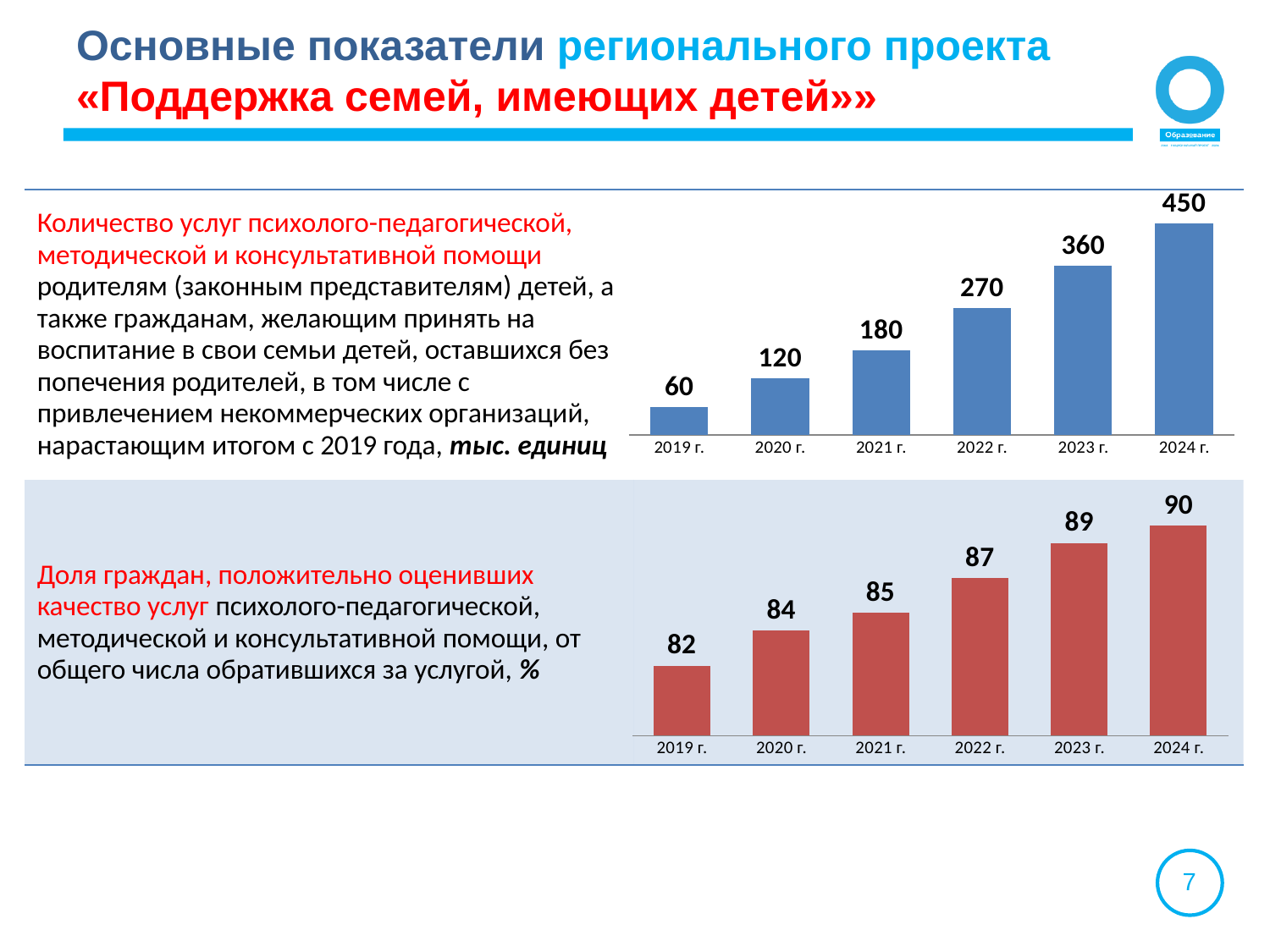
In the top chart (number of services, thousand units), how many years are shown on the x axis? 6 In the top chart (number of services, thousand units), what is the difference between the values for 2024 г. and 2019 г.? 390 In the top chart (number of services, thousand units), do the values rise or fall from 2019 г. to 2024 г.? rise In the bottom chart (share of citizens positively rating service quality, %), what is the value for 2021 г.? 85 In the bottom chart (share of citizens positively rating service quality, %), which year has the lowest value? 2019 г. What type of chart is the bottom chart (share of citizens positively rating service quality, %)? bar chart In the top chart (number of services, thousand units), which year has the highest value? 2024 г. In the top chart (number of services, thousand units), what is the value for 2020 г.? 120 What colour are the bars in the bottom chart (share of citizens positively rating service quality, %)? red In the bottom chart (share of citizens positively rating service quality, %), which is larger: the value for 2022 г. or the value for 2024 г.? 2024 г. In the bottom chart (share of citizens positively rating service quality, %), what is the difference between the values for 2023 г. and 2020 г.? 5 In the top chart (number of services, thousand units), what is the value for 2022 г.? 270